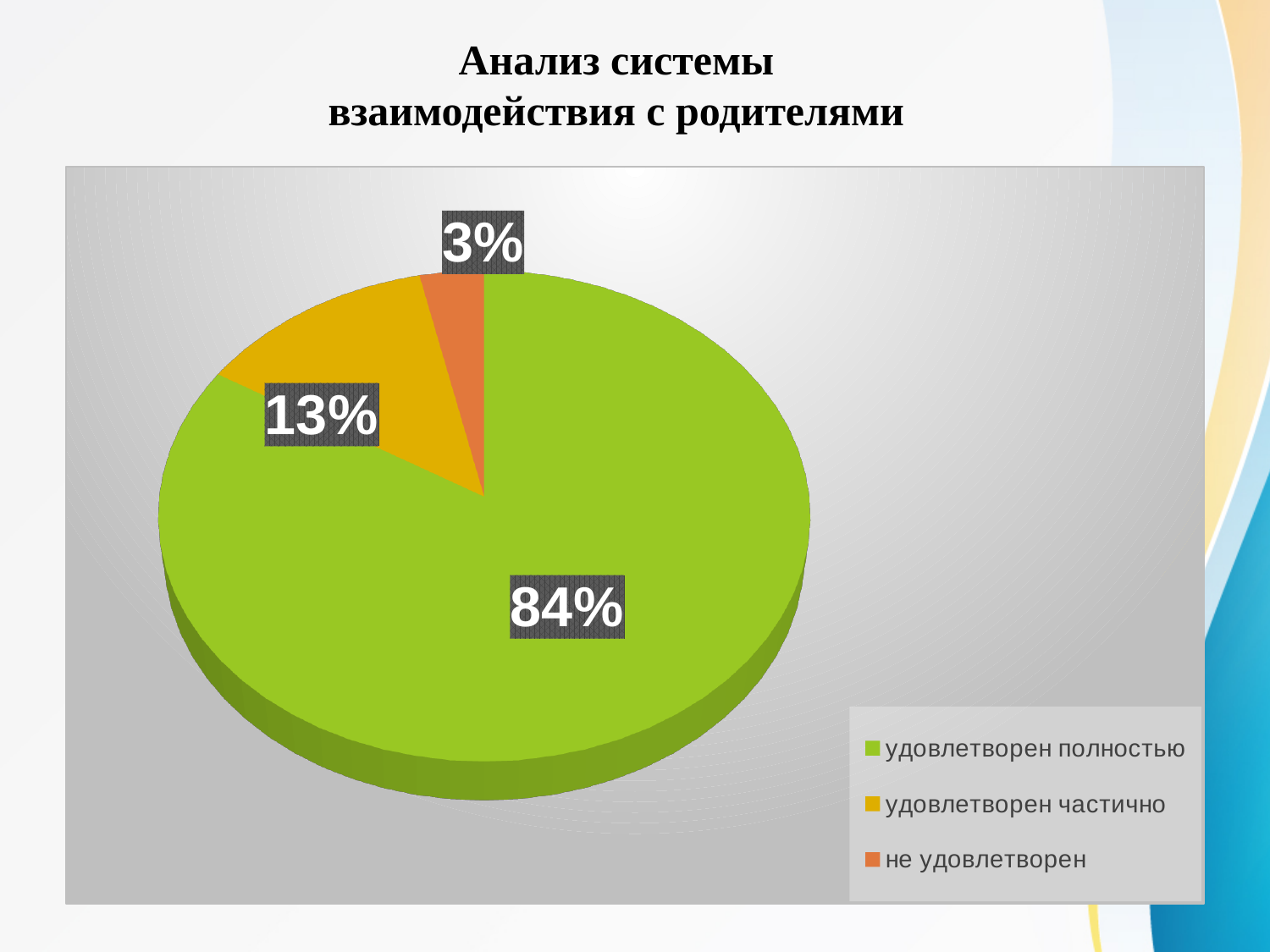
How many slices does the pie chart have? 3 Which is larger: the slice for "удовлетворен частично" or the slice for "не удовлетворен"? удовлетворен частично What share of the pie is labelled "удовлетворен частично"? 13% Which category has the largest slice of the pie? удовлетворен полностью What kind of chart is shown on the slide? pie chart What is the difference in percentage points between "удовлетворен полностью" and "удовлетворен частично"? 71 How many entries does the legend list? 3 Which category has the smallest slice of the pie? не удовлетворен What is the difference in percentage points between "удовлетворен частично" and "не удовлетворен"? 10 What share of the pie is labelled "не удовлетворен"? 3% What share of the pie is labelled "удовлетворен полностью"? 84% What colour is the slice for "не удовлетворен"? orange